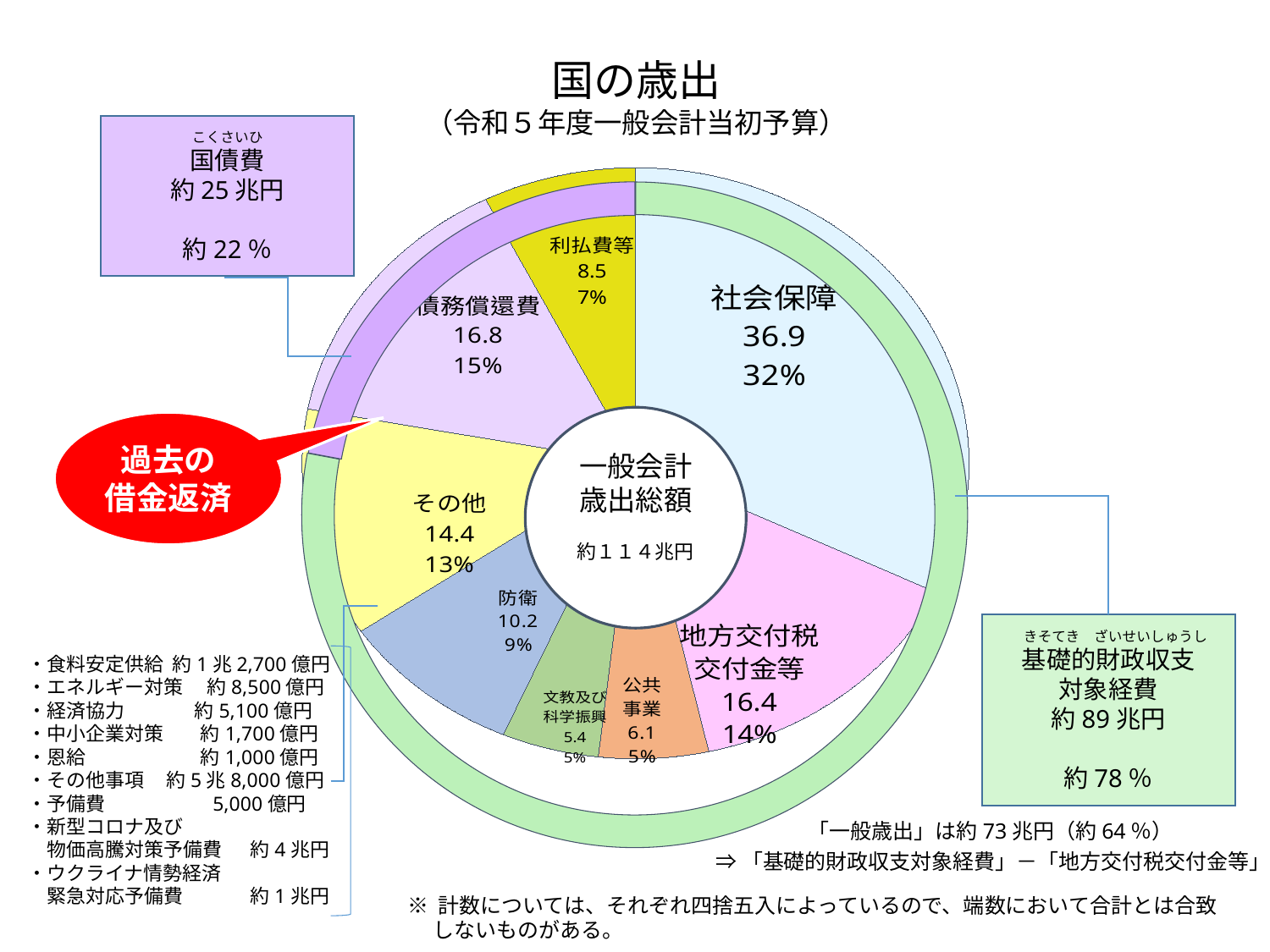
What percentage share is shown for 債務償還費? 15% What kind of chart is shown on the slide? pie chart What total is written in the centre of the pie chart? 約１１４兆円 What is the value shown for 社会保障? 36.9 How many categories are shown in the pie chart? 8 Which category has the largest slice of the pie? 社会保障 What is the difference between the values for 社会保障 and 地方交付税交付金等? 20.5 Which category has the smallest value in the pie? 文教及び科学振興 What is the value shown for 防衛? 10.2 Which is larger, the value for 債務償還費 or the value for その他? 債務償還費 What is the title of the chart? 国の歳出（令和５年度一般会計当初予算） What percentage share is shown for 地方交付税交付金等? 14%